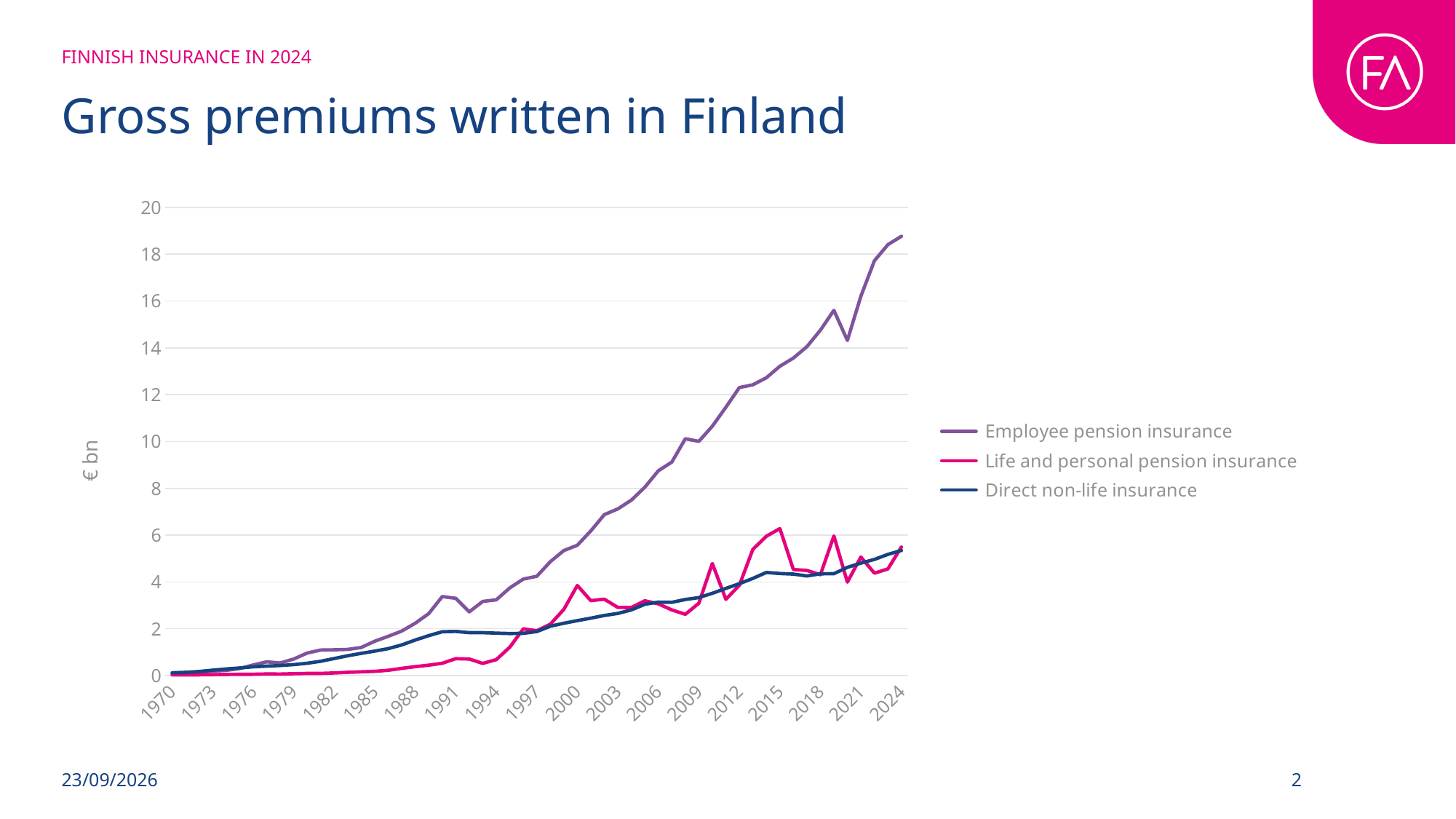
Is the value for Employee pension insurance in 2012 greater or less than 10? greater Is the value for Life and personal pension insurance in 2024 greater or less than 6? less What unit is shown on the vertical axis label? € bn How many series does the legend list? 3 Which series has the highest value in 2024? Employee pension insurance What is the title of the chart? Gross premiums written in Finland In 1991, which is larger: Direct non-life insurance or Life and personal pension insurance? Direct non-life insurance In 2015, which is larger: Life and personal pension insurance or Direct non-life insurance? Life and personal pension insurance Is the value for Employee pension insurance in 2024 greater or less than 18? greater What kind of chart is shown on the slide? Line chart Does the Employee pension insurance series generally rise or fall from 1970 to 2024? Rise